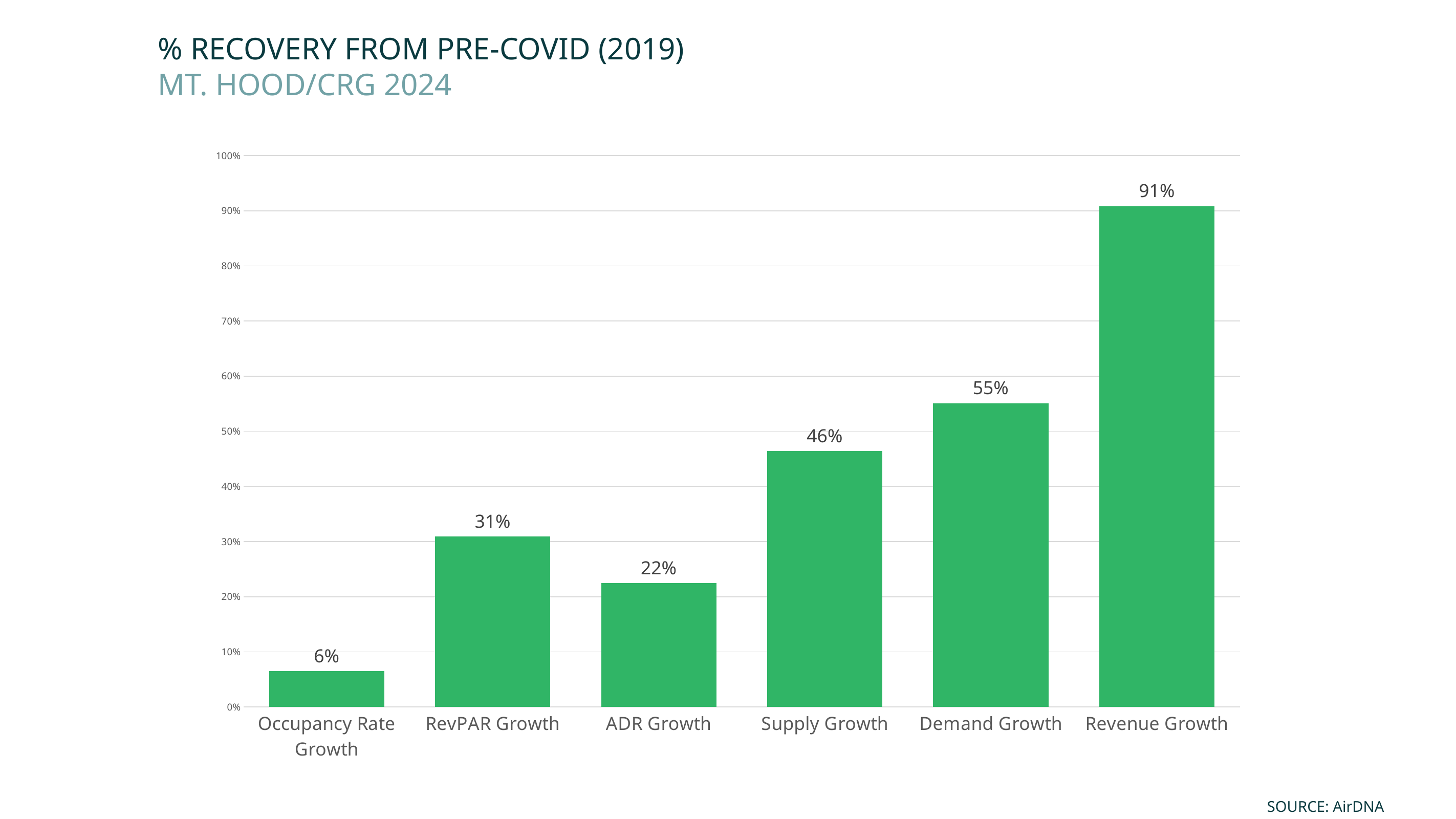
What kind of chart is shown on the slide? Bar chart Which category has the highest value? Revenue Growth What is the value for Revenue Growth? 91% What is the value for Occupancy Rate Growth? 6% What is the value for Supply Growth? 46% What is the difference between Revenue Growth and RevPAR Growth? 60% Which is larger, RevPAR Growth or ADR Growth? RevPAR Growth How many categories are shown in the chart? 6 What is the source cited for the chart? AirDNA What is the value for ADR Growth? 22% What is the difference between Demand Growth and Supply Growth? 9% Which category has the lowest value? Occupancy Rate Growth